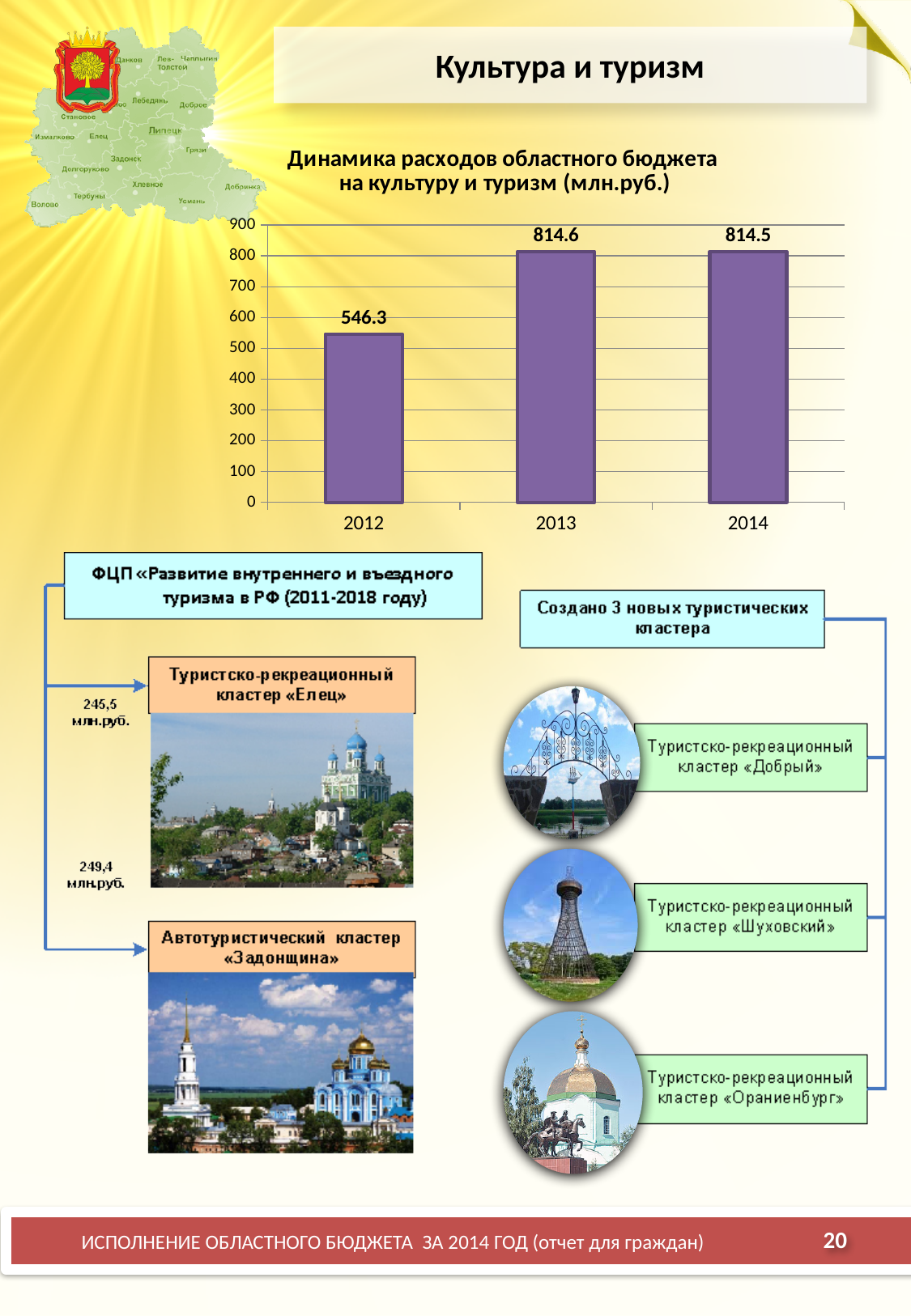
Which year has the lowest value in the chart? 2012 What is the difference between the values for 2013 and 2012? 268.3 What is the value for 2012 in the chart? 546.3 What is the value for 2013 in the chart? 814.6 What kind of chart is shown on the slide? bar chart In what units are the values in the chart expressed, according to its title? млн.руб. Did the value rise or fall from 2012 to 2013? rise What is the value for 2014 in the chart? 814.5 Is the value for 2012 greater or less than 600? less How many years are shown on the x axis of the chart? 3 Which is larger, the value for 2012 or the value for 2014? 2014 What is the difference between the values for 2014 and 2012? 268.2